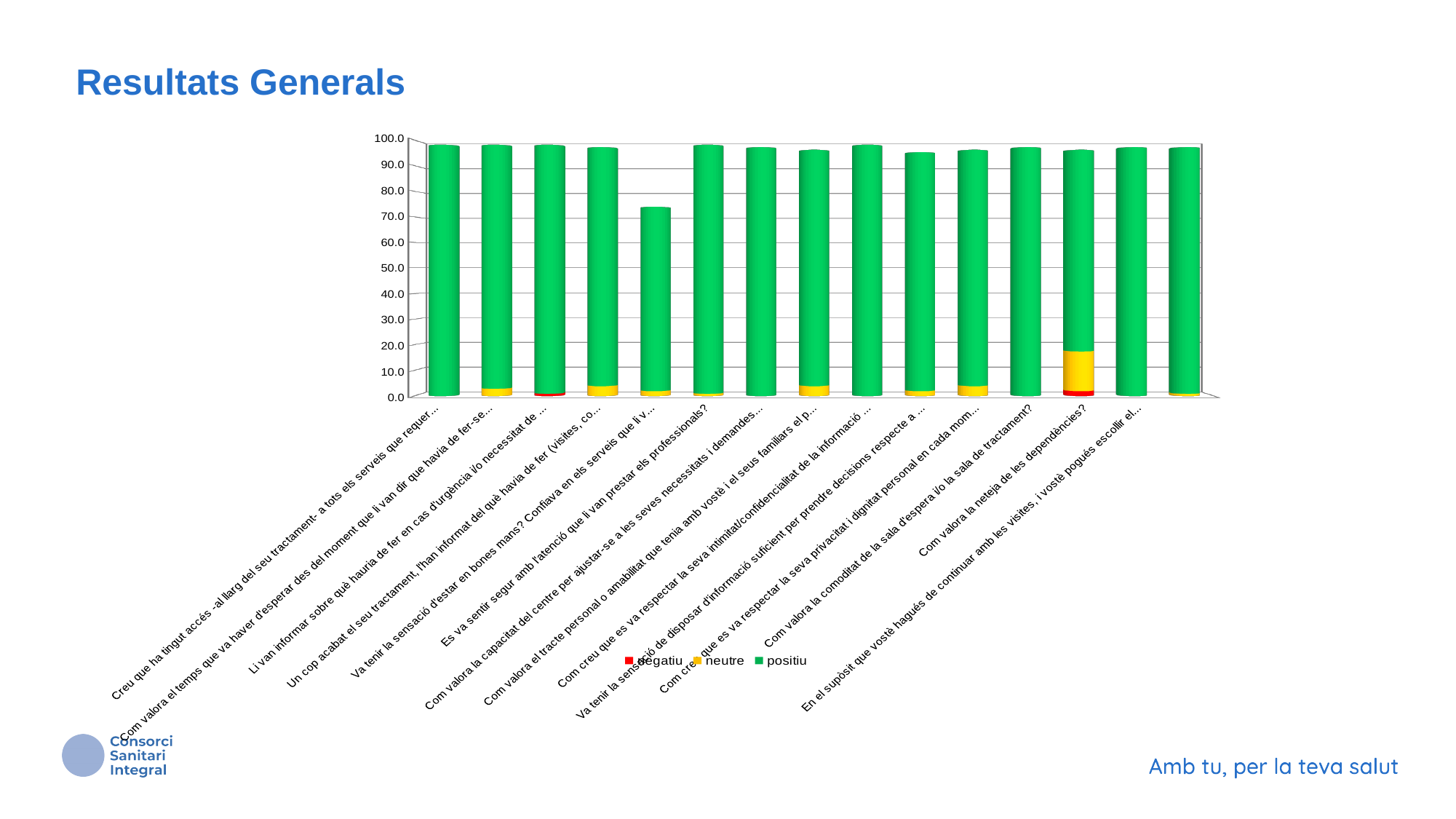
Is the total bar height for 'Com valora la neteja de les dependències?' greater or less than 90? greater Which category has the shortest bar overall? Va tenir la sensació d'estar en bones mans? What are the series names listed in the legend? negatiu, neutre, positiu Which bar is taller: 'Com valora la neteja de les dependències?' or 'Va tenir la sensació d'estar en bones mans?'? Com valora la neteja de les dependències? Is the total bar height for 'Creu que ha tingut accés...' greater or less than 90? greater What kind of chart is shown on the slide? Stacked bar chart Is the total bar height for 'Va tenir la sensació d'estar en bones mans?' greater or less than 70? greater How many series does the legend list? 3 Which category has the largest 'neutre' (yellow) segment? Com valora la neteja de les dependències? Which colour represents the 'positiu' series? Green